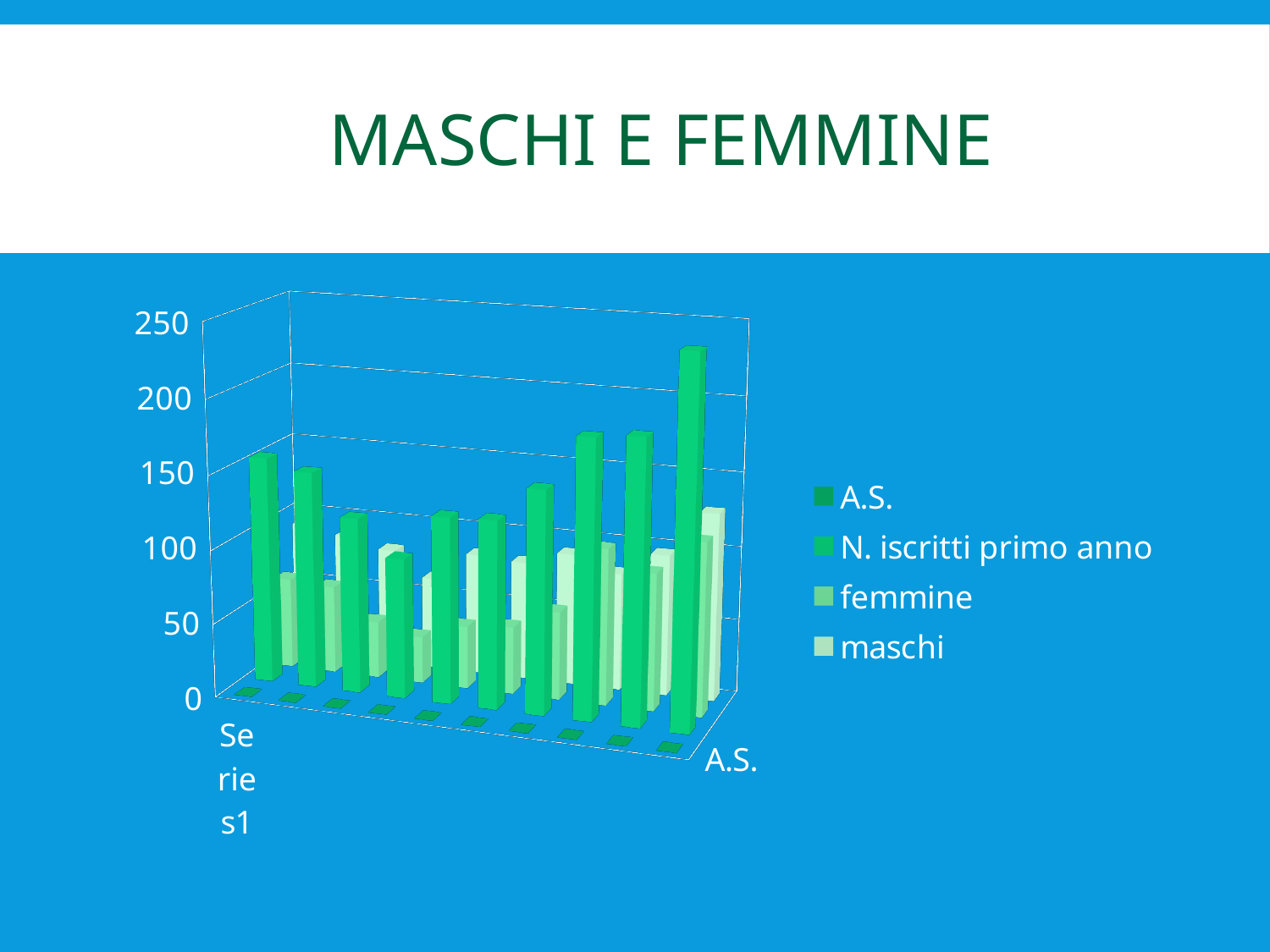
What is the highest value shown on the vertical axis of the chart? 250 How many series does the chart legend list? 4 What kind of chart is shown on the slide? bar chart What is the title of the slide containing the chart? MASCHI E FEMMINE Which series is listed last in the chart legend? maschi Which series has the tallest bars in the chart? N. iscritti primo anno How many groups of bars are plotted along the x axis of the chart? 10 Is the tallest 'N. iscritti primo anno' bar greater or less than 200? greater